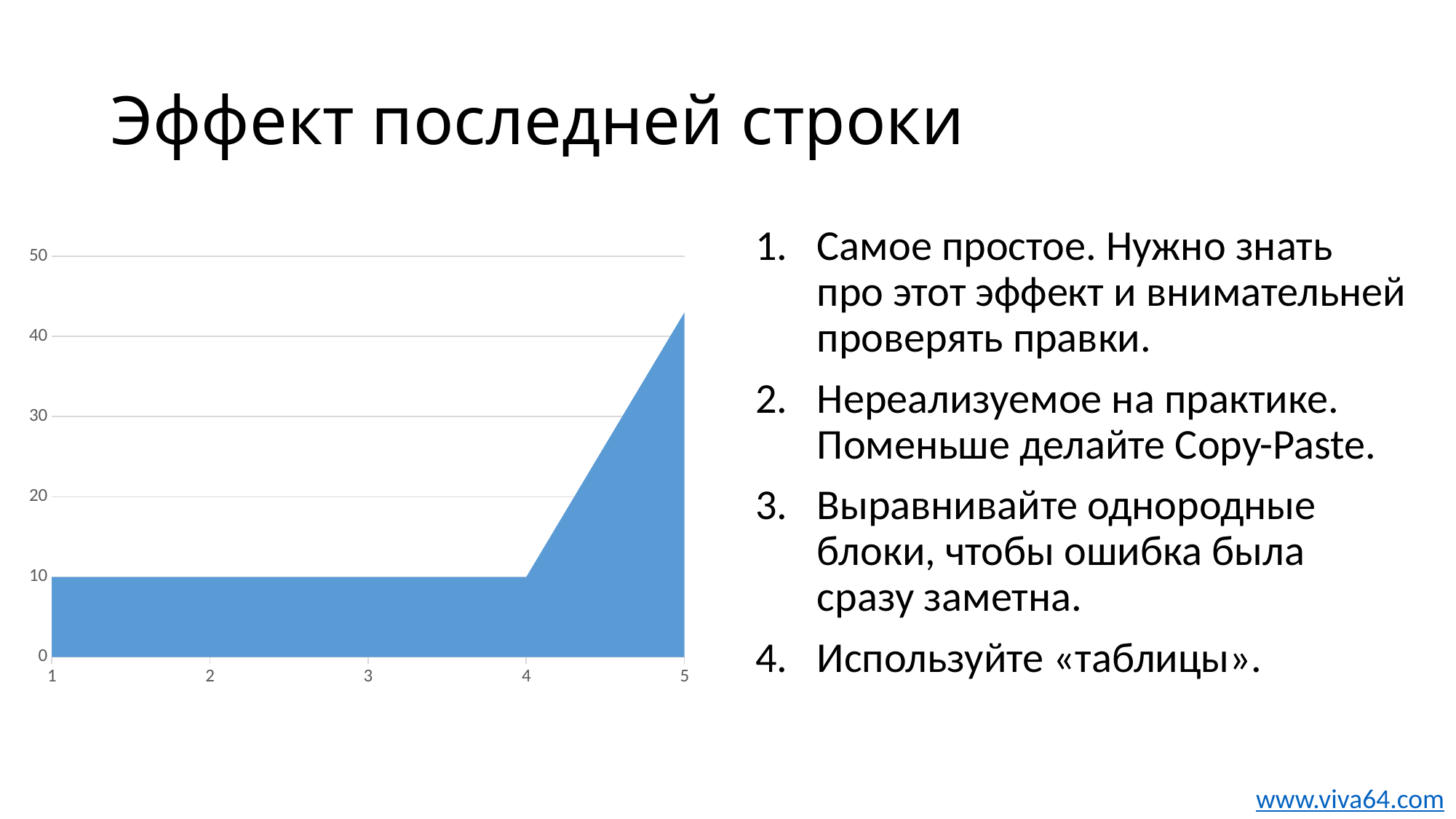
At which x value does the chart reach its highest value? 5 Which has the larger value, x = 3 or x = 5? 5 What is the highest tick shown on the y axis of the chart? 50 Does the value change between x = 1 and x = 4? No, it stays flat at 10 What is the value at x = 1 on the chart? 10 Is the value at x = 5 greater or less than 40? greater Does the value rise or fall between x = 4 and x = 5? rise What is the value at x = 4 on the chart? 10 How many points are plotted along the x axis of the chart? 5 Is the value at x = 5 greater or less than 50? less What colour is the filled area in the chart? Blue What kind of chart is shown on the slide? Area chart